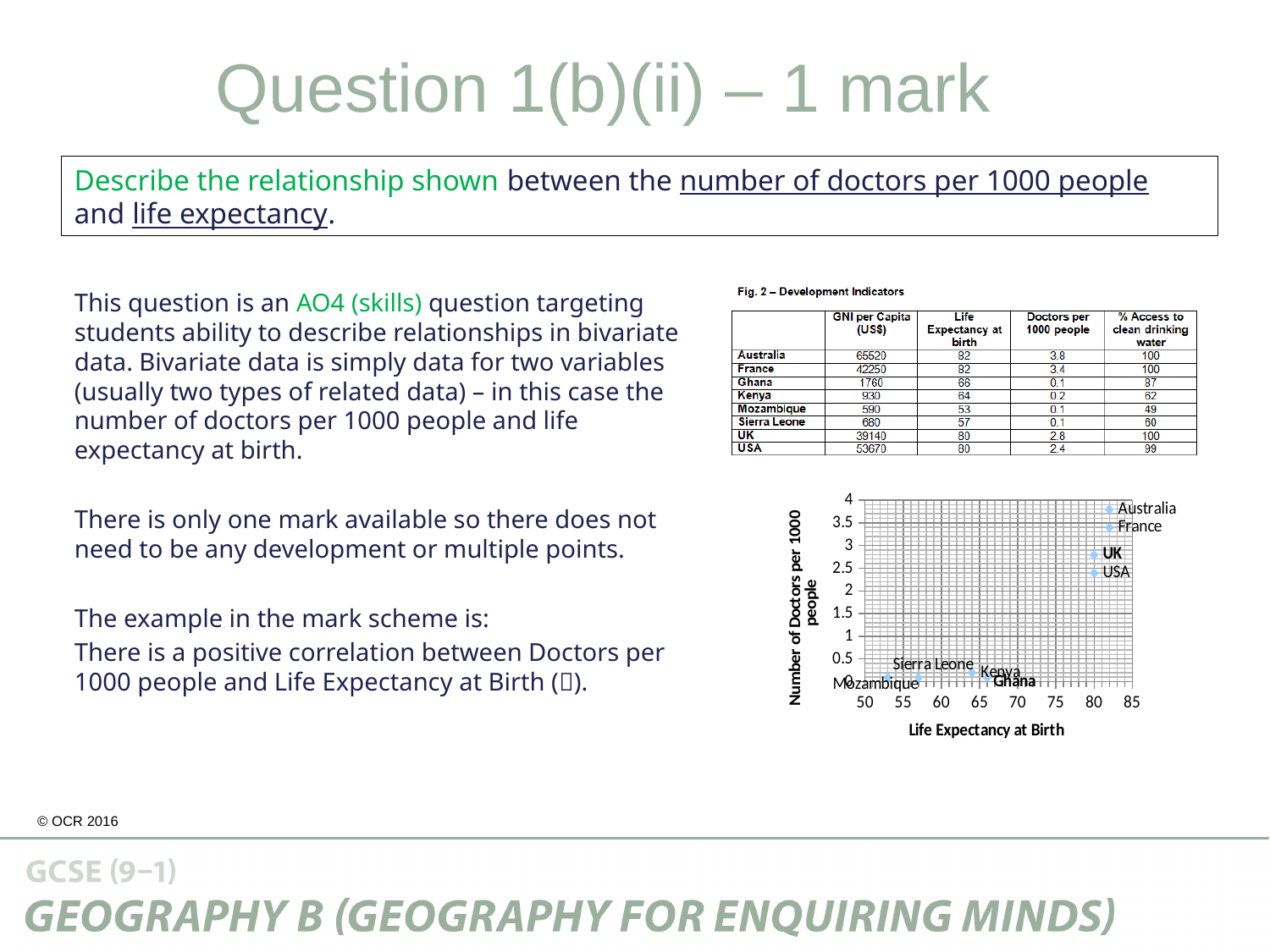
Is the life expectancy at birth for Mozambique greater or less than 55? less As life expectancy at birth increases along the x axis, does the number of doctors per 1000 people generally rise or fall? rise What is the title of the y axis of the scatter chart? Number of Doctors per 1000 people Which country has the highest number of doctors per 1000 people on the scatter chart? Australia What type of chart is shown on the slide? scatter chart According to the table on the slide, how many doctors per 1000 people does Kenya have? 0.2 Which has more doctors per 1000 people, the UK or the USA? UK Is the number of doctors per 1000 people for Australia greater or less than 3.5? greater Is the number of doctors per 1000 people for the USA greater or less than 3? less How many countries are plotted as points on the scatter chart? 8 What is the title of the x axis of the scatter chart? Life Expectancy at Birth Which has more doctors per 1000 people, France or the UK? France